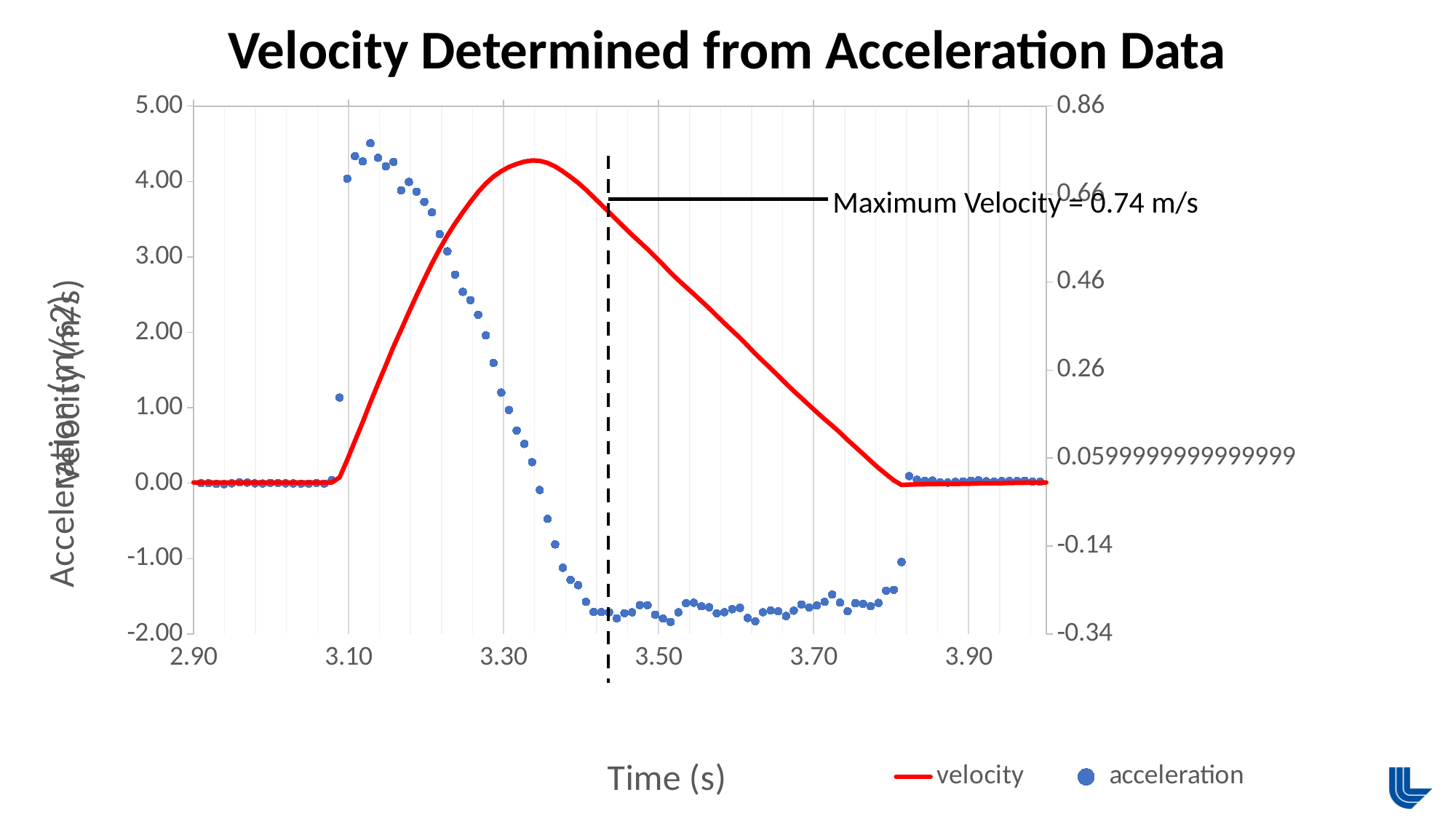
What maximum velocity does the annotation on the chart state? 0.74 m/s What colour is the velocity line on the chart? red What kind of chart is used for the velocity series? line chart Is the acceleration value at 3.30 s greater or less than 0.00? greater Is the peak of the velocity curve greater or less than 0.66 on the right-hand axis? greater Does the velocity rise or fall along the x axis between 3.10 s and 3.30 s? rise Does the velocity rise or fall along the x axis between 3.50 s and 3.80 s? fall What is the title of the chart? Velocity Determined from Acceleration Data What kind of chart is used for the acceleration series? scatter chart How many series does the chart legend list? 2 Is the acceleration value at 3.50 s greater or less than -1.00? less